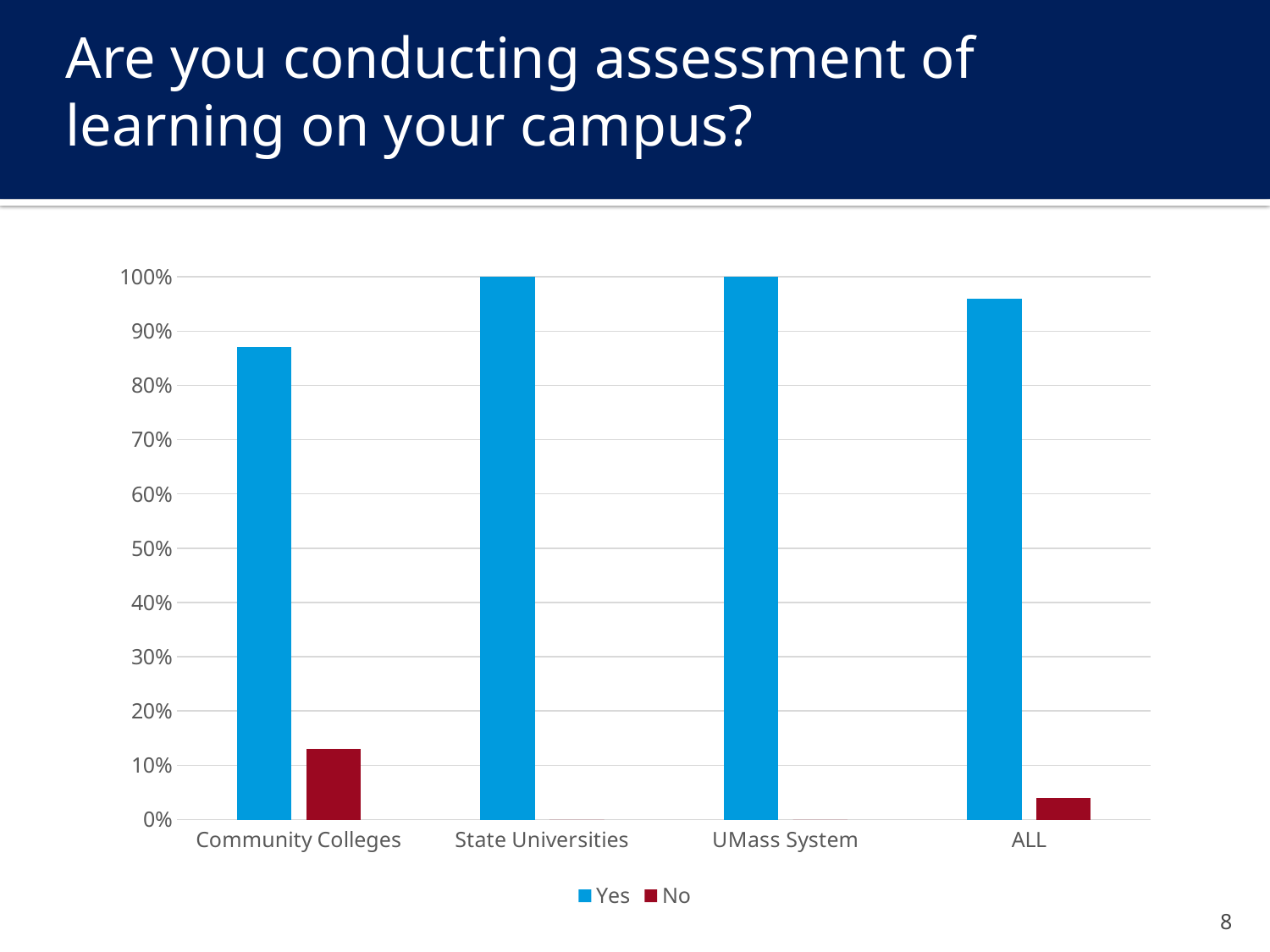
Is the Yes value for ALL greater or less than 90%? greater Which category has the lowest Yes value? Community Colleges Is the No value for ALL greater or less than 10%? less What is the Yes value for UMass System? 100% What is the Yes value for State Universities? 100% How many series does the legend list? 2 How many categories are shown on the x axis? 4 Is the Yes value for Community Colleges greater or less than 80%? greater Which is larger, the No value for Community Colleges or the No value for ALL? Community Colleges What kind of chart is shown on the slide? bar chart What colour are the Yes bars? blue